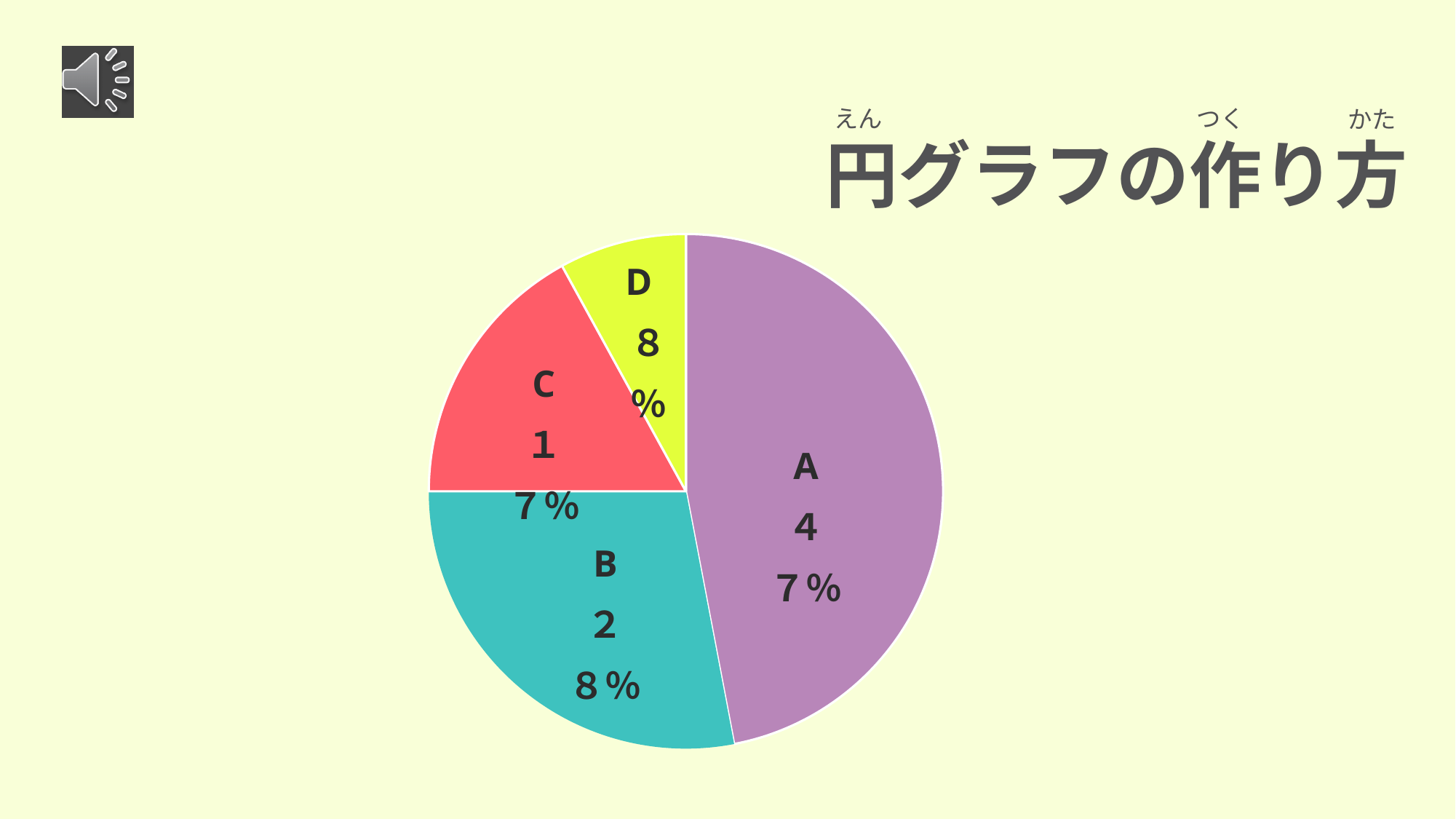
What colour is slice A? purple How many slices does the pie chart have? 4 What percentage is shown for slice A? 47% What percentage is shown for slice B? 28% What kind of chart is shown on the slide? pie chart What percentage is shown for slice D? 8% Which slice of the pie is the smallest? D Which is larger, slice B or slice C? B What is the difference in percentage points between slice A and slice B? 19 What is the combined share of slices C and D? 25% Which slice of the pie is the largest? A What percentage is shown for slice C? 17%